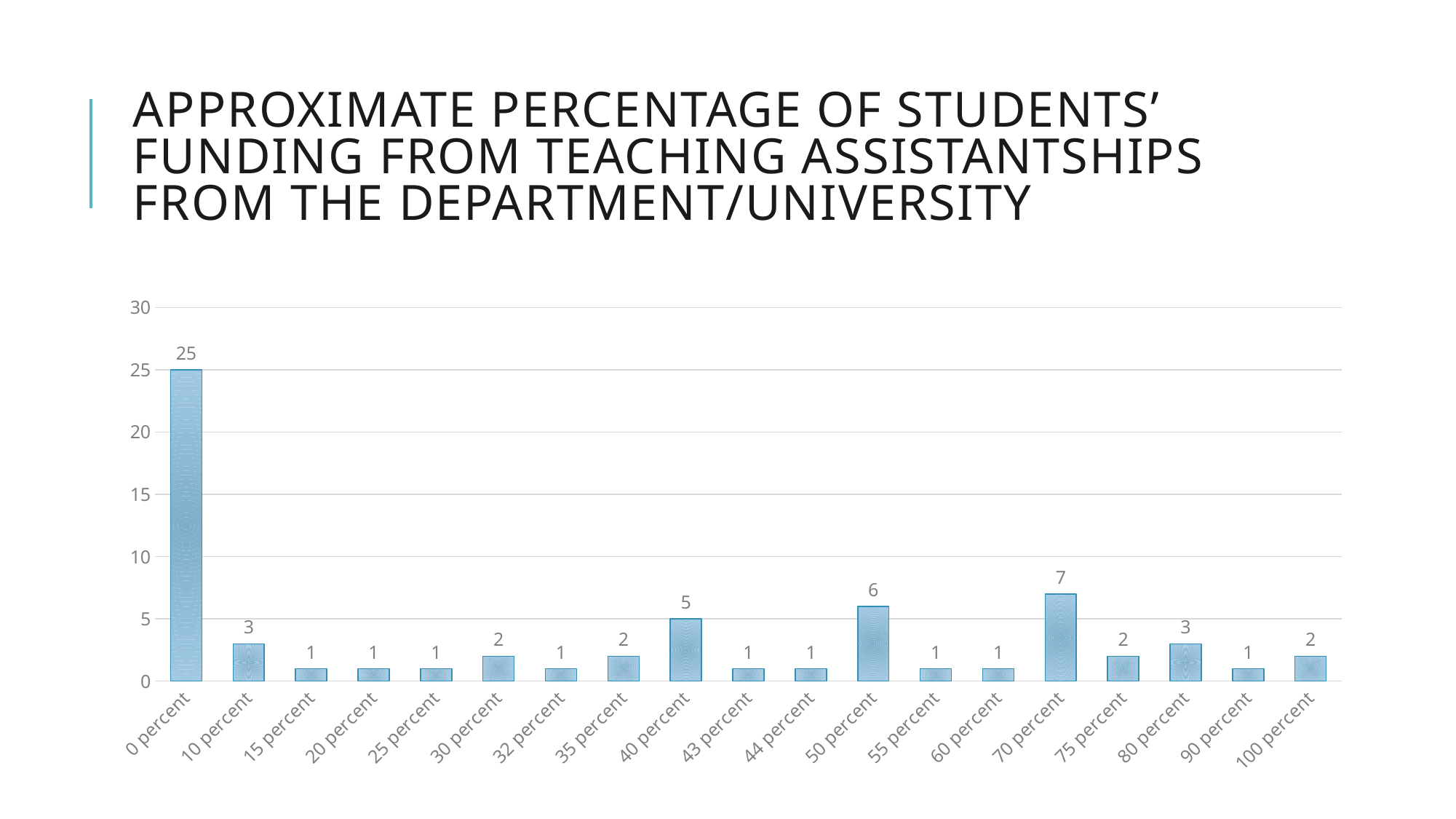
Is the value for 0 percent greater or less than 20? greater What kind of chart is shown on the slide? bar chart What is the value for 40 percent? 5 What is the value for 0 percent? 25 How many categories are shown on the x axis? 19 What is the value for 70 percent? 7 Which is larger, the value for 70 percent or the value for 50 percent? 70 percent What is the value for 80 percent? 3 Which category has the highest value? 0 percent What is the difference between the values for 50 percent and 40 percent? 1 What is the value for 50 percent? 6 What is the difference between the values for 0 percent and 70 percent? 18